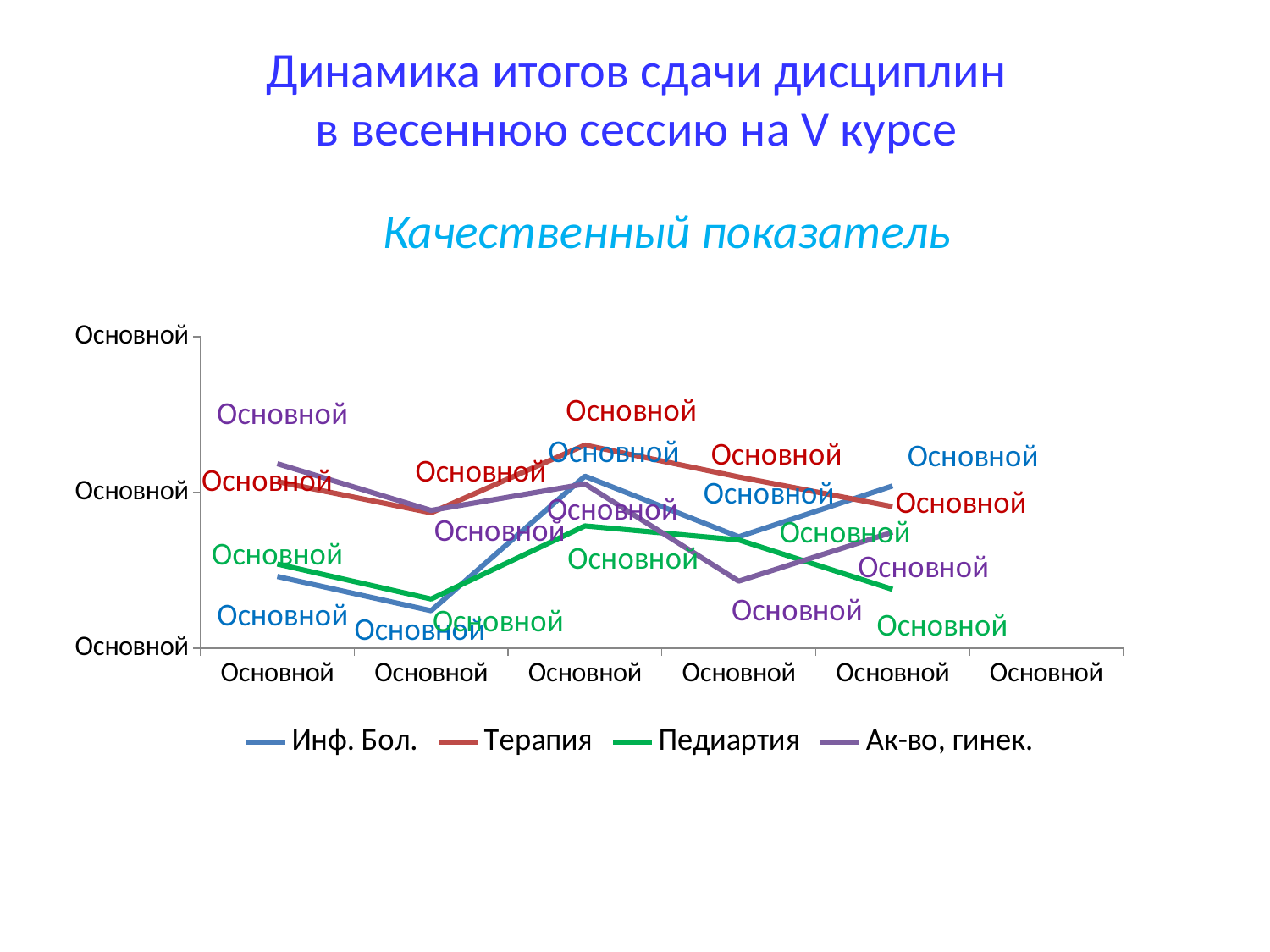
Which series has the highest value at the leftmost point of the chart? Ак-во, гинек. How many data points does the Терапия line have? 5 What type of chart is shown on the slide? line chart At the rightmost point, which is higher: Инф. Бол. or Ак-во, гинек.? Инф. Бол. How many series does the legend list? 4 What are the series names listed in the legend? Инф. Бол., Терапия, Педиартия, Ак-во, гинек. At the leftmost point, which is higher: Терапия or Педиартия? Терапия Which series has the highest value at the third (middle) point of the chart? Терапия What is the subtitle shown above the chart? Качественный показатель Which series has the lowest value at the rightmost point of the chart? Педиартия Which colour is used for the Педиартия line? green